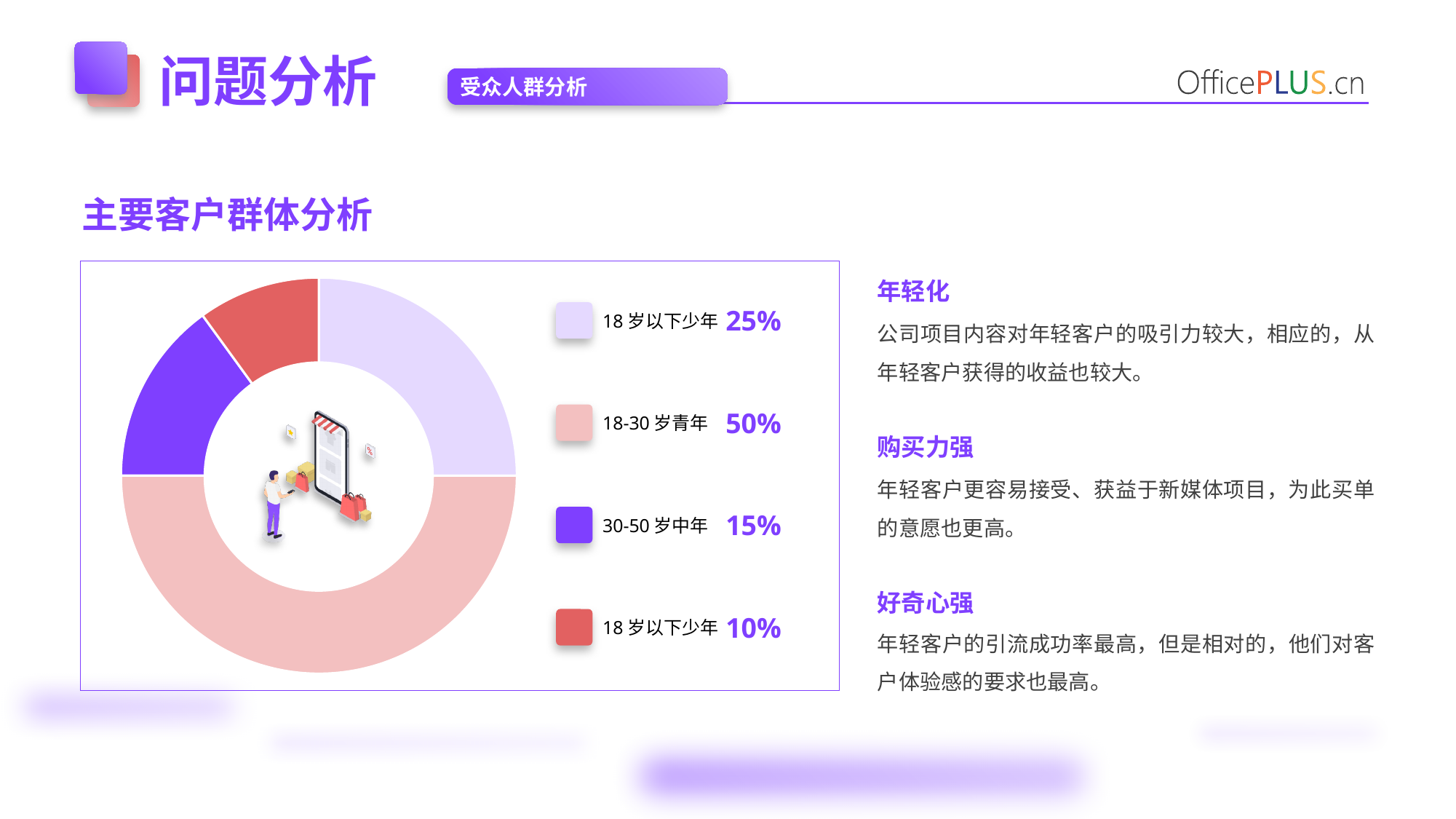
How many entries does the legend list? 4 Which category has the largest share of the donut chart? 18-30 岁青年 Which is larger: the share for 30-50 岁中年 or the share for the red segment? 30-50 岁中年 What percentage is shown for 18-30 岁青年? 50% What kind of chart is shown on the slide? Pie chart (donut) Which legend entry has the smallest share of the donut chart? The last entry (red, 10%) What is the difference between the share for 18-30 岁青年 and the share for 30-50 岁中年? 35% What percentage is shown for the last legend entry (red segment)? 10% How many segments does the donut chart have? 4 What percentage is shown for the first legend entry, 18 岁以下少年 (light purple)? 25% What percentage is shown for 30-50 岁中年? 15% What colour is the segment representing 18-30 岁青年? Pink